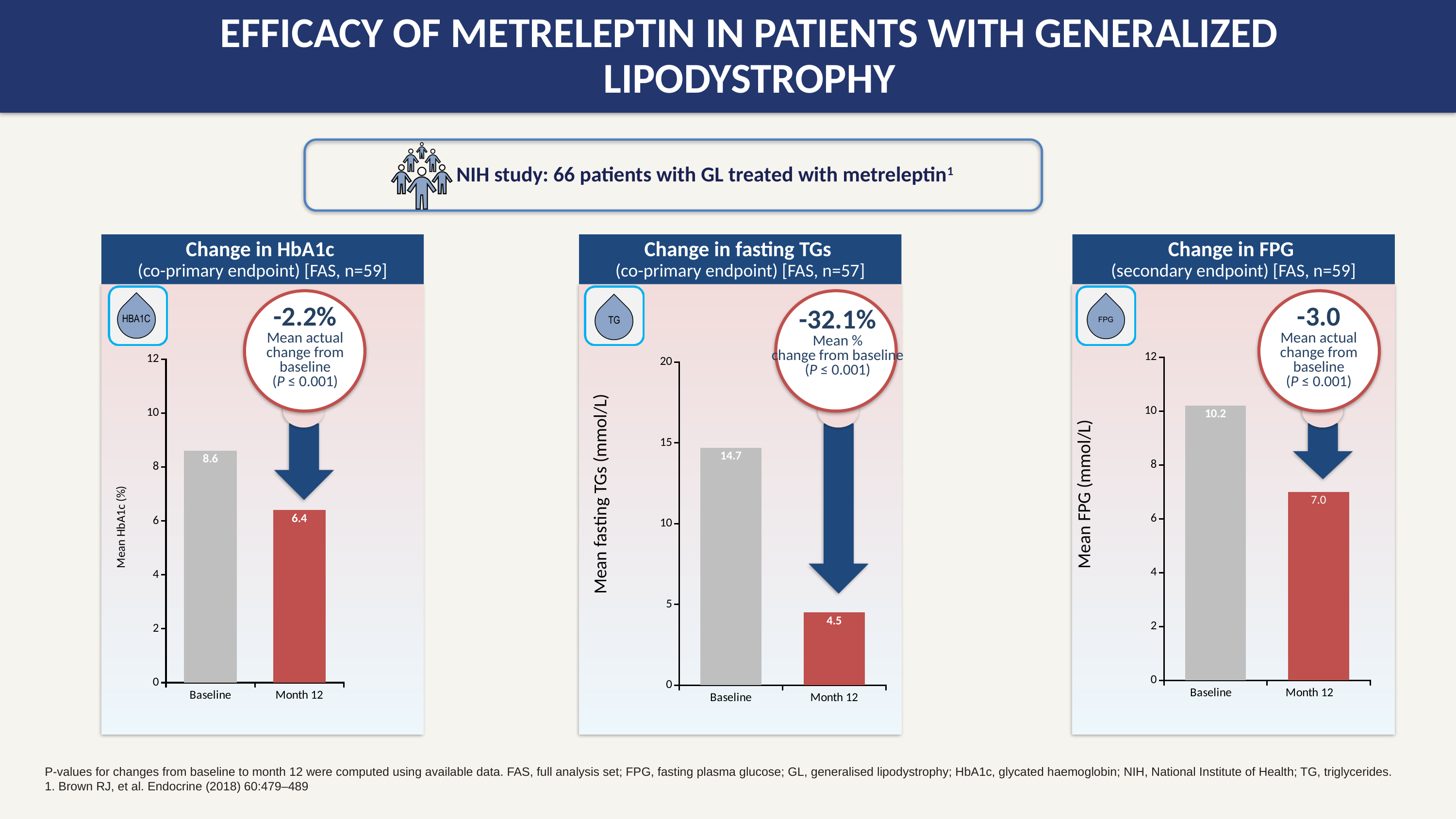
In the 'Change in FPG' chart, what is the mean FPG value at Month 12? 7.0 In the 'Change in HbA1c' chart, what is the mean HbA1c value at Month 12? 6.4 What kind of chart is the 'Change in FPG' chart? Bar chart In the 'Change in fasting TGs' chart, what is the mean fasting TG value at Baseline? 14.7 In the 'Change in fasting TGs' chart, which category has the lowest value? Month 12 In the 'Change in fasting TGs' chart, what is the difference between the Baseline and Month 12 values? 10.2 How many categories are shown on the x axis of the 'Change in HbA1c' chart? 2 In the 'Change in HbA1c' chart, what is the mean HbA1c value at Baseline? 8.6 In the 'Change in FPG' chart, do the values rise or fall from Baseline to Month 12? Fall In the 'Change in fasting TGs' chart, what is the mean fasting TG value at Month 12? 4.5 In the 'Change in FPG' chart, what is the difference between the Baseline and Month 12 values? 3.2 In the 'Change in HbA1c' chart, which category has the higher value, Baseline or Month 12? Baseline